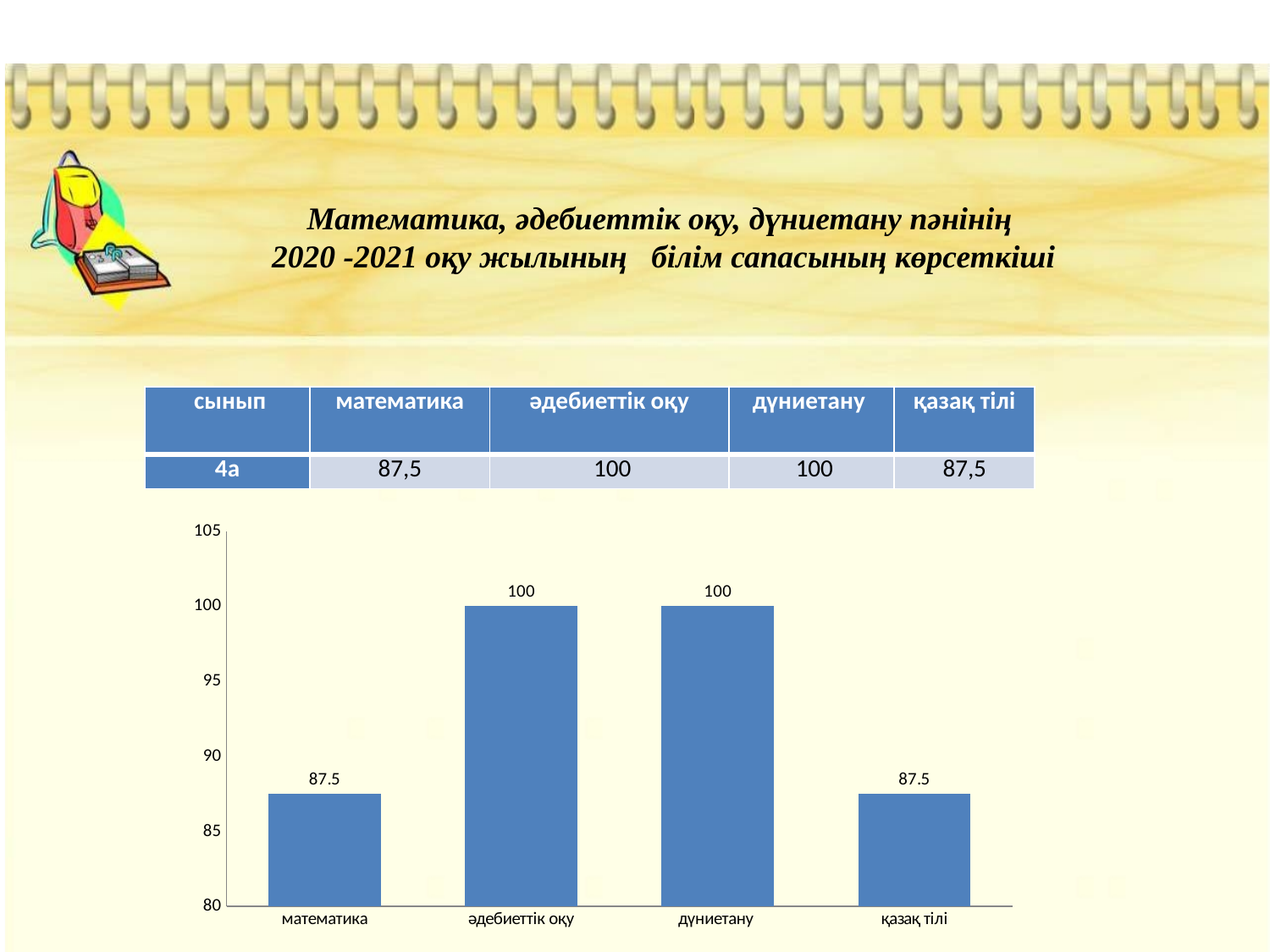
Is the value for математика in the bar chart greater or less than 90? less What is the value for дүниетану in the bar chart? 100 What is the value for қазақ тілі in the bar chart? 87.5 How many categories are shown in the bar chart? 4 Which is larger in the bar chart, the value for әдебиеттік оқу or the value for математика? әдебиеттік оқу Which is larger in the bar chart, the value for қазақ тілі or the value for дүниетану? дүниетану What is the value for әдебиеттік оқу in the bar chart? 100 What is the value for математика in the bar chart? 87.5 What kind of chart is shown on the slide? bar chart Is the value for әдебиеттік оқу in the bar chart greater or less than 95? greater What colour are the bars in the chart? blue What is the difference between the value for дүниетану and the value for қазақ тілі in the bar chart? 12.5